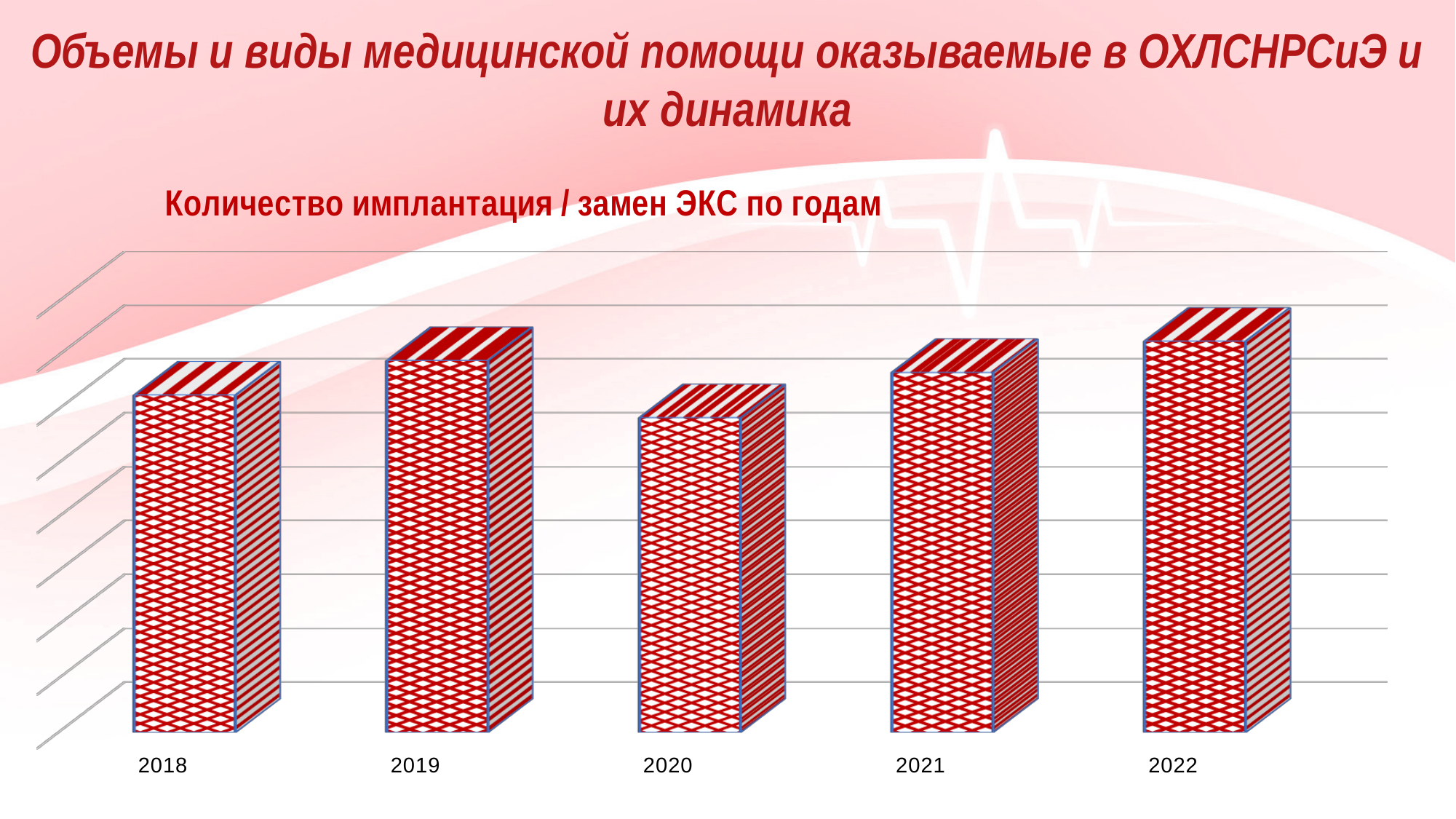
Does the value rise or fall from 2020 to 2022? rise Does the value rise or fall from 2018 to 2019? rise Does the value rise or fall from 2019 to 2020? fall What kind of chart is shown on the slide? bar chart What is the title of the chart? Количество имплантация / замен ЭКС по годам Which year has the larger value, 2018 or 2020? 2018 Which year has the larger value, 2021 or 2022? 2022 How many years are shown on the x axis of the chart? 5 What is the first year shown on the x axis of the chart? 2018 Which year has the lowest bar in the chart? 2020 Which year has the larger value, 2019 or 2020? 2019 Which year has the highest bar in the chart? 2022